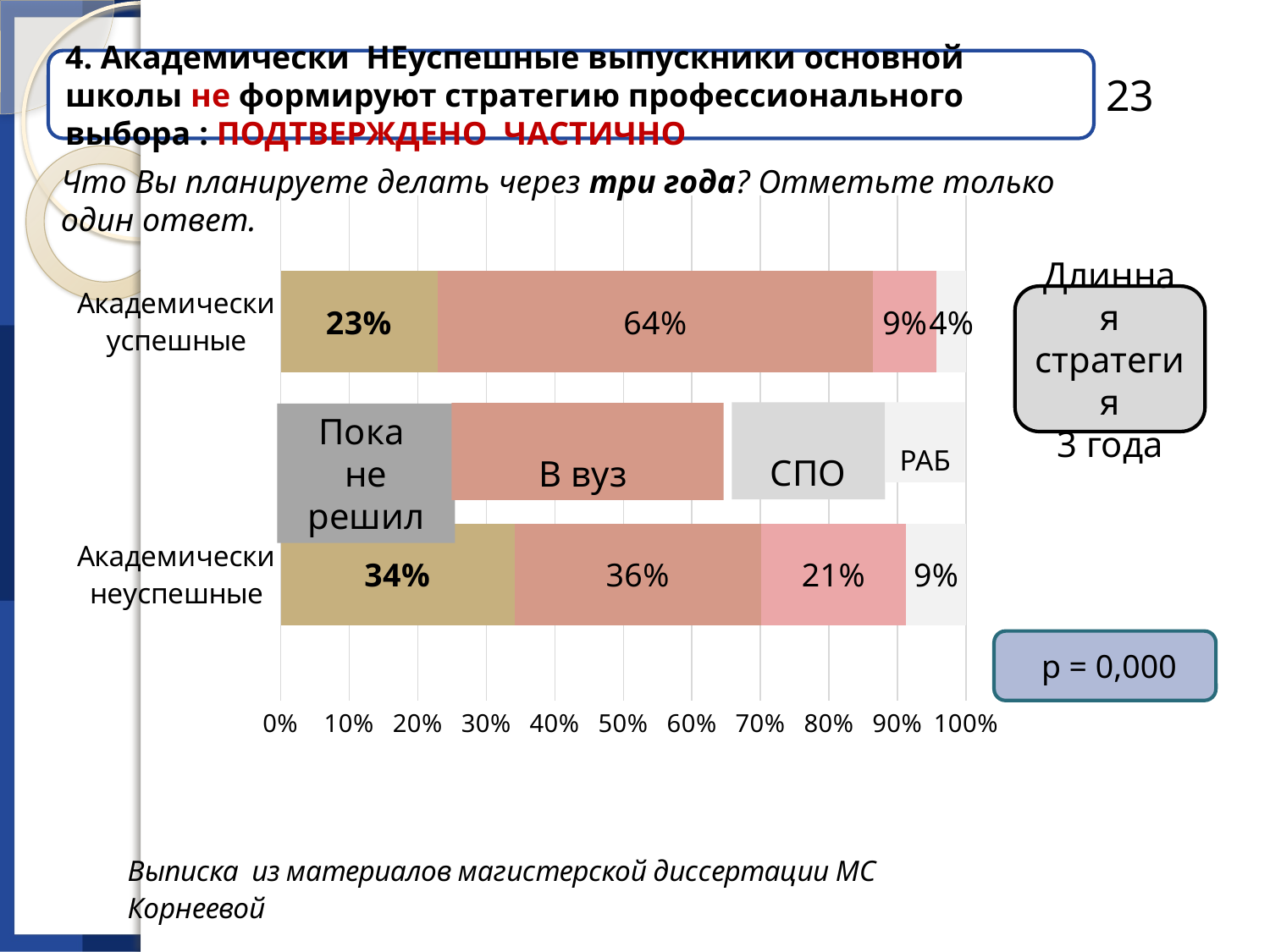
Which group has the larger "Пока не решил" share, "Академически успешные" or "Академически неуспешные"? Академически неуспешные What is the value of the "СПО" segment for "Академически неуспешные"? 21% What is the value of the "В вуз" segment for "Академически успешные"? 64% What is the value of the "Пока не решил" segment for "Академически успешные"? 23% What is the difference between the "В вуз" values for "Академически успешные" and "Академически неуспешные"? 28% What kind of chart is shown on the slide? stacked bar chart Which segment is the smallest for "Академически успешные"? РАБ What is the value of the "Пока не решил" segment for "Академически неуспешные"? 34% How many categories (bars) does the chart show? 2 How many segment labels (series) are shown for the bars? 4 What is the value of the "РАБ" segment for "Академически неуспешные"? 9% Which segment is the largest for "Академически успешные"? В вуз